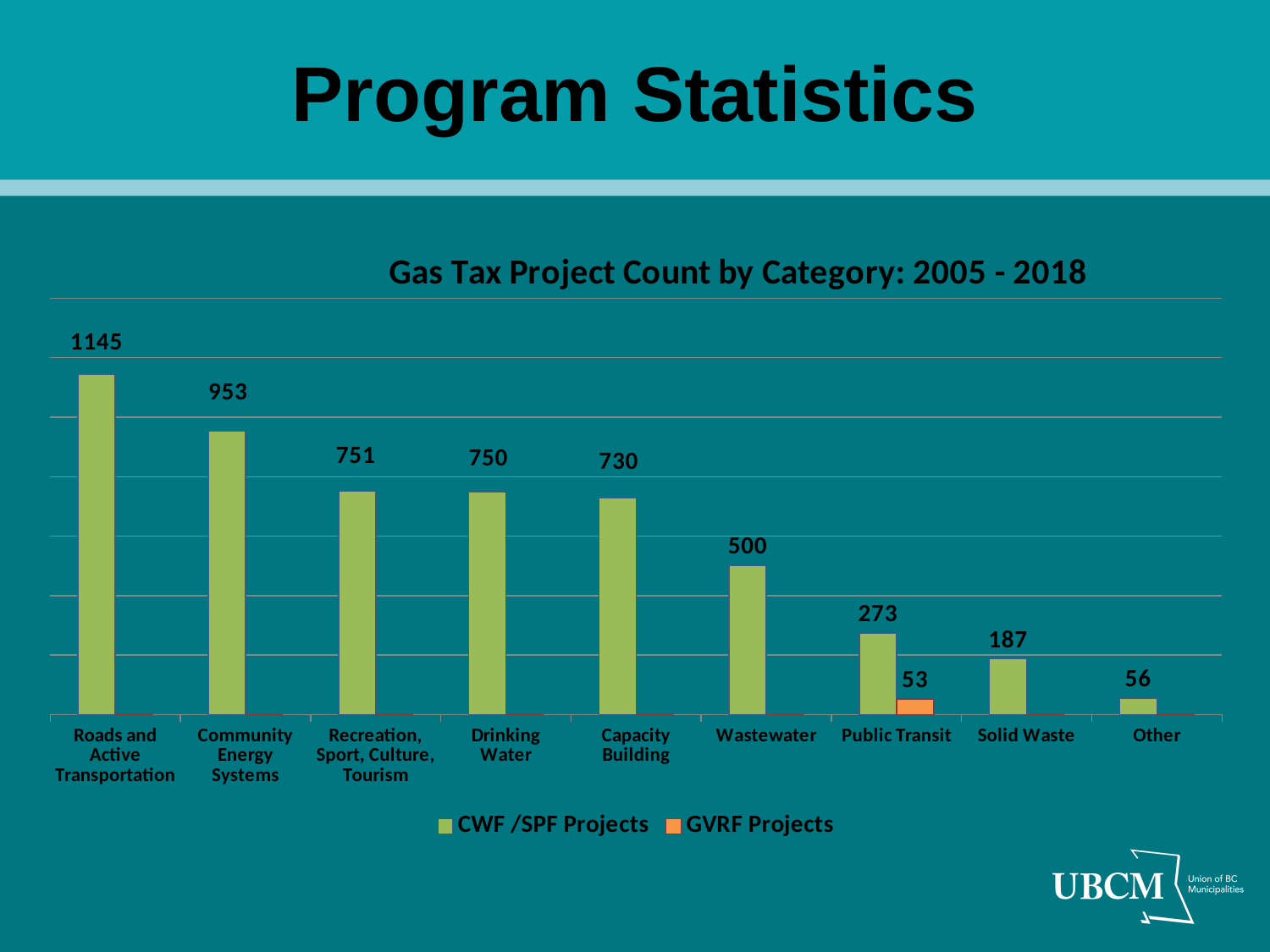
What is the difference between the CWF/SPF Projects values for Recreation, Sport, Culture, Tourism and Drinking Water? 1 What is the title of the chart? Gas Tax Project Count by Category: 2005 - 2018 What is the CWF/SPF Projects value for Roads and Active Transportation? 1145 Which category has the highest CWF/SPF Projects count? Roads and Active Transportation What is the CWF/SPF Projects value for Wastewater? 500 What is the GVRF Projects value for Public Transit? 53 Which is larger, the CWF/SPF Projects value for Capacity Building or for Wastewater? Capacity Building What is the difference between the CWF/SPF Projects values for Roads and Active Transportation and Community Energy Systems? 192 Which category has the lowest CWF/SPF Projects count? Other How many categories are shown on the x axis? 9 What is the CWF/SPF Projects value for Solid Waste? 187 How many series does the legend list? 2